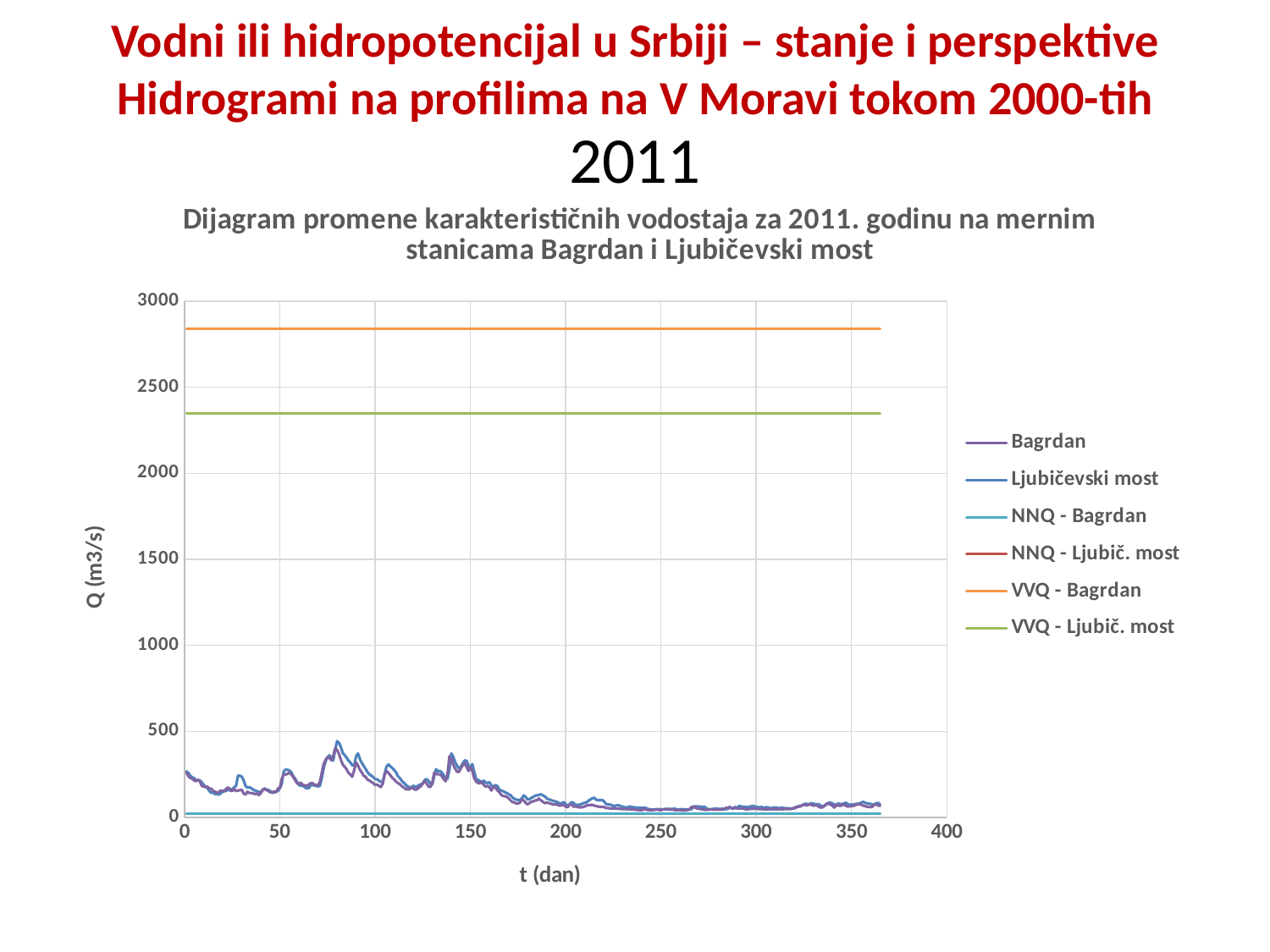
What is the title of the chart? Dijagram promene karakterističnih vodostaja za 2011. godinu na mernim stanicama Bagrdan i Ljubičevski most Overall, does the Ljubičevski most series rise or fall from day 0 to day 365? fall Is the highest value of the Bagrdan series greater or less than 500? less Which series has the highest values on the chart? VVQ - Bagrdan Is the value of the VVQ - Bagrdan line greater or less than 2500? greater What kind of chart is shown on the slide? line chart How many series does the legend list? 6 Is the value of the VVQ - Ljubič. most line greater or less than 2000? greater What is the label of the vertical axis? Q (m3/s) Which is larger, the VVQ - Bagrdan line or the VVQ - Ljubič. most line? VVQ - Bagrdan